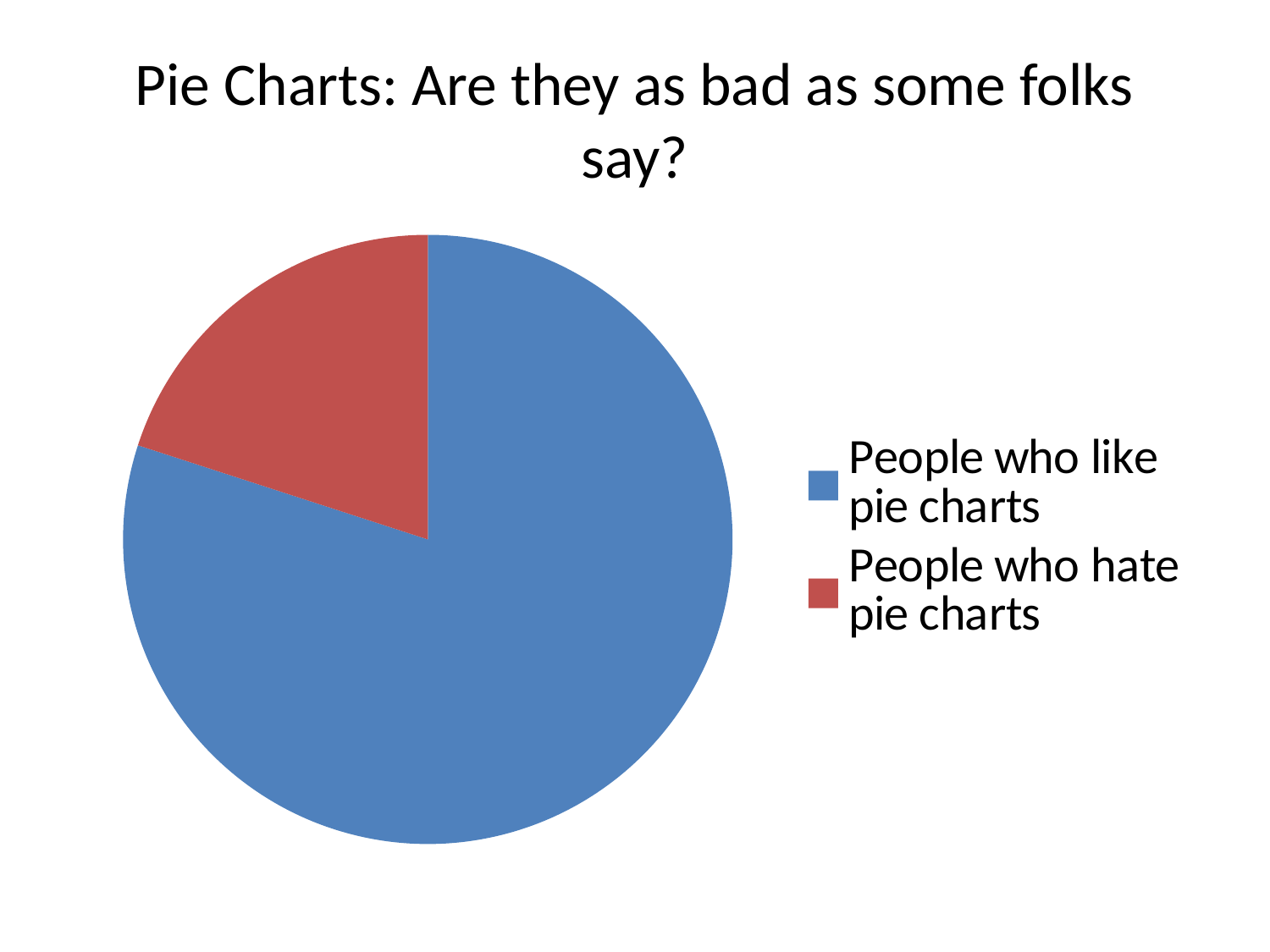
What colour is the slice for People who hate pie charts? Red Which category has the smallest slice of the pie chart? People who hate pie charts Which slice is larger: People who like pie charts or People who hate pie charts? People who like pie charts How many entries does the legend of the pie chart list? 2 How many slices does the pie chart have? 2 What colour is the slice for People who like pie charts? Blue What kind of chart is shown on the slide? Pie chart Which category has the largest slice of the pie chart? People who like pie charts